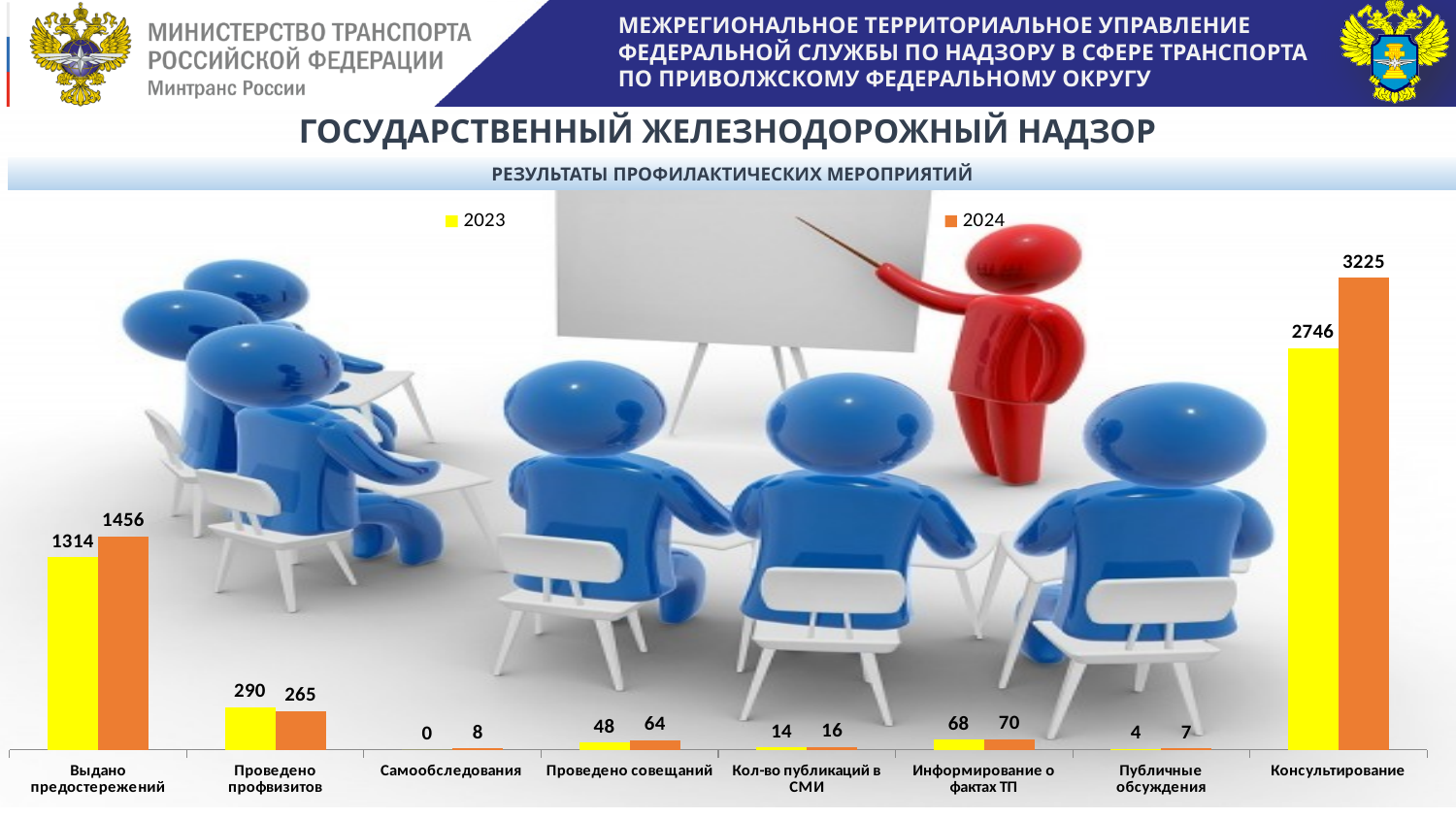
What is the difference between the 2023 and 2024 values for Проведено профвизитов? 25 Which category has the lowest 2023 value? Самообследования What is the 2024 value for Консультирование? 3225 What is the 2024 value for Самообследования? 8 Which is larger for Выдано предостережений, the 2023 value or the 2024 value? 2024 What is the 2023 value for Проведено совещаний? 48 What kind of chart is shown on the slide? Bar chart Which category has the highest 2024 value? Консультирование How many categories are shown on the x axis? 8 How many series does the legend list? 2 What is the 2023 value for Выдано предостережений? 1314 What is the difference between the 2024 and 2023 values for Консультирование? 479